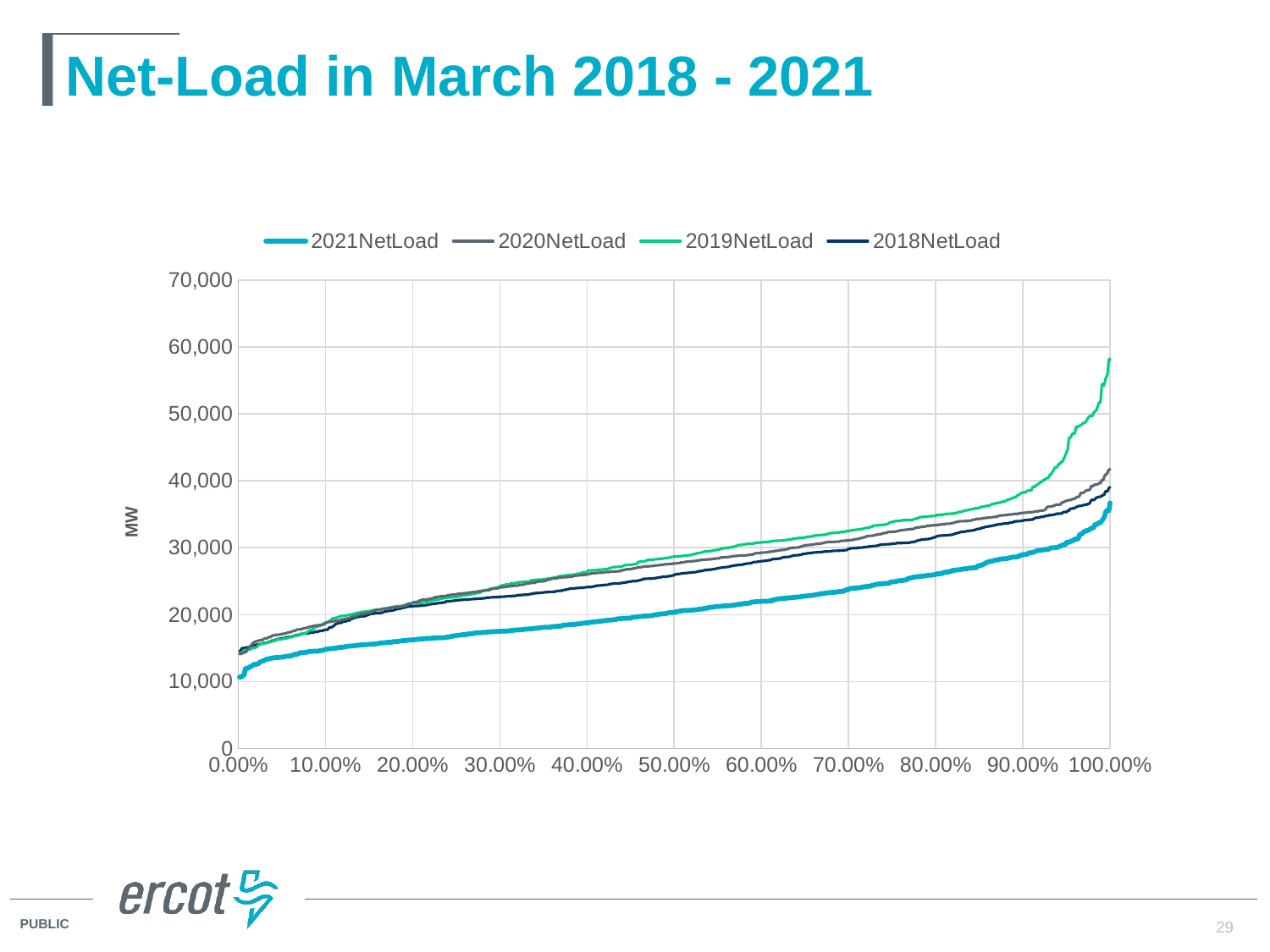
At 100.00% on the x axis, which is larger: 2019NetLoad or 2020NetLoad? 2019NetLoad Do the values of the 2021NetLoad series rise or fall as you move from 0.00% to 100.00% along the x axis? Rise What is the label on the vertical axis? MW Is the value for 2019NetLoad at 100.00% greater or less than 50,000? greater What is the title of the chart? Net-Load in March 2018 - 2021 Which series reaches the highest value at the 100.00% end of the x axis? 2019NetLoad How many series does the legend list? 4 Is the value for 2021NetLoad at 0.00% greater or less than 20,000? less Is the value for 2021NetLoad at 50.00% greater or less than 30,000? less Which series has the lowest values across most of the x axis? 2021NetLoad At 50.00% on the x axis, which is larger: 2019NetLoad or 2021NetLoad? 2019NetLoad What kind of chart is shown on the slide? Line chart